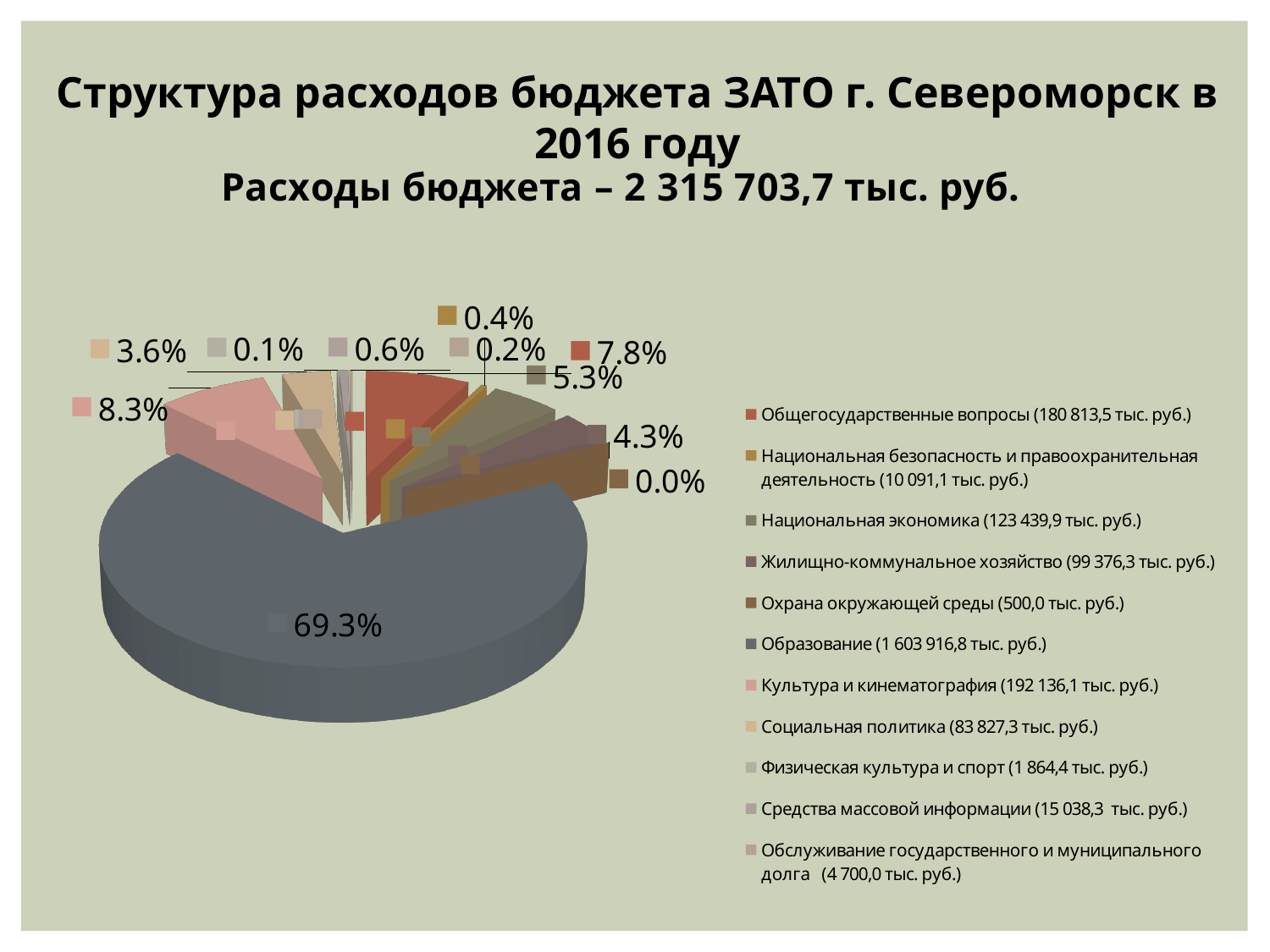
What share of the budget expenditures goes to Общегосударственные вопросы? 7.8% Which has a larger share: Социальная политика or Жилищно-коммунальное хозяйство? Жилищно-коммунальное хозяйство What share of the budget expenditures goes to Образование? 69.3% What total budget expenditure amount is stated in the slide title? 2 315 703,7 тыс. руб. How many categories does the legend of the pie chart list? 11 What share of the budget expenditures goes to Национальная экономика? 5.3% Which category has the largest share of the pie? Образование What is the difference in percentage points between the shares of Культура и кинематография and Общегосударственные вопросы? 0.5% Which category has the smallest share of the pie? Охрана окружающей среды What type of chart is shown on the slide? pie chart